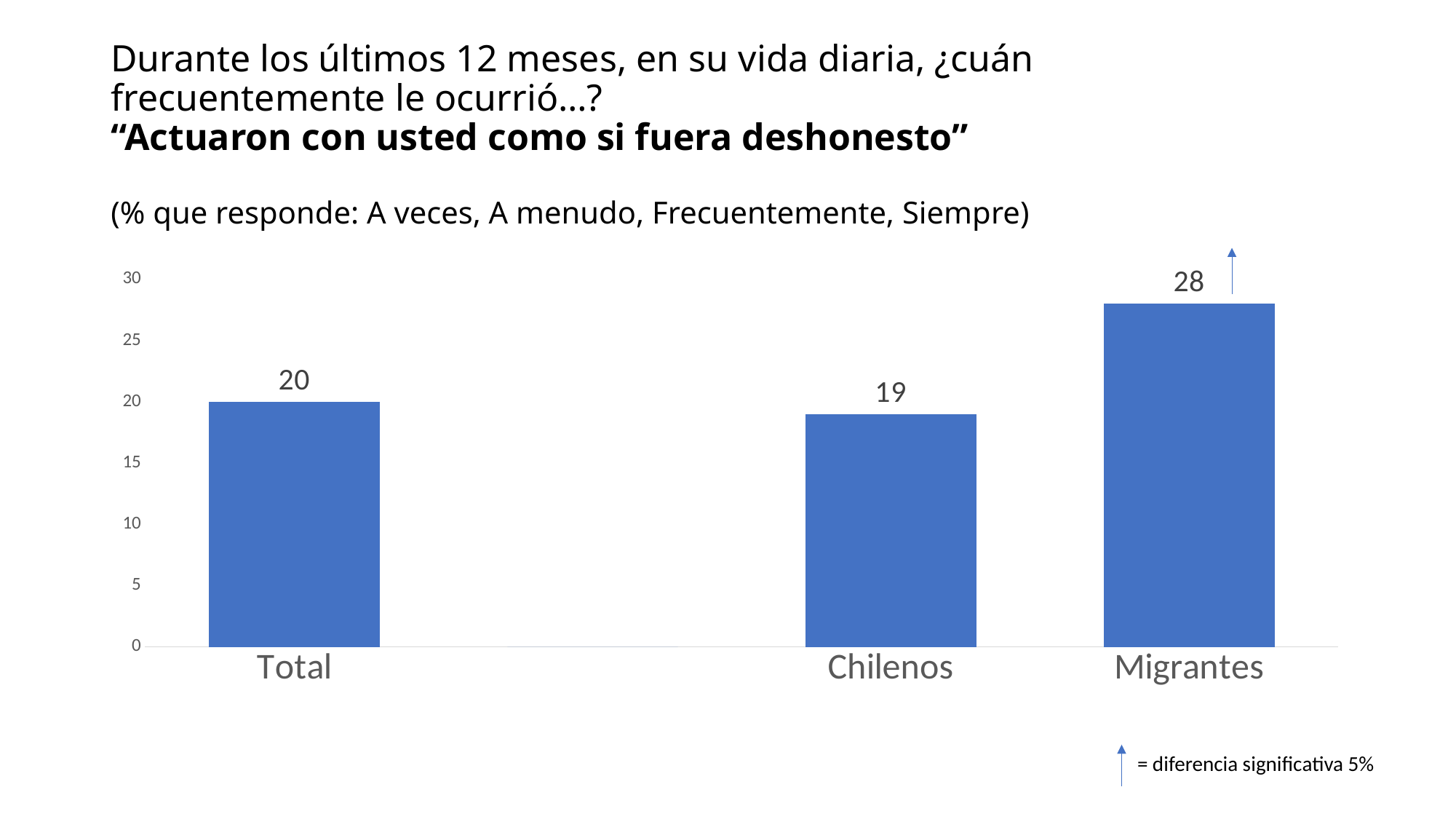
What is the value for Total? 20 Is the value for Migrantes greater or less than 25? greater According to the legend note, what does the blue arrow indicate? diferencia significativa 5% What is the value for Migrantes? 28 How many categories are shown on the x axis? 3 What kind of chart is shown on the slide? bar chart Which category has the highest value? Migrantes Which category has the lowest value? Chilenos What is the difference between the values for Migrantes and Chilenos? 9 Which is larger, the value for Migrantes or the value for Total? Migrantes What is the difference between the values for Migrantes and Total? 8 What is the value for Chilenos? 19